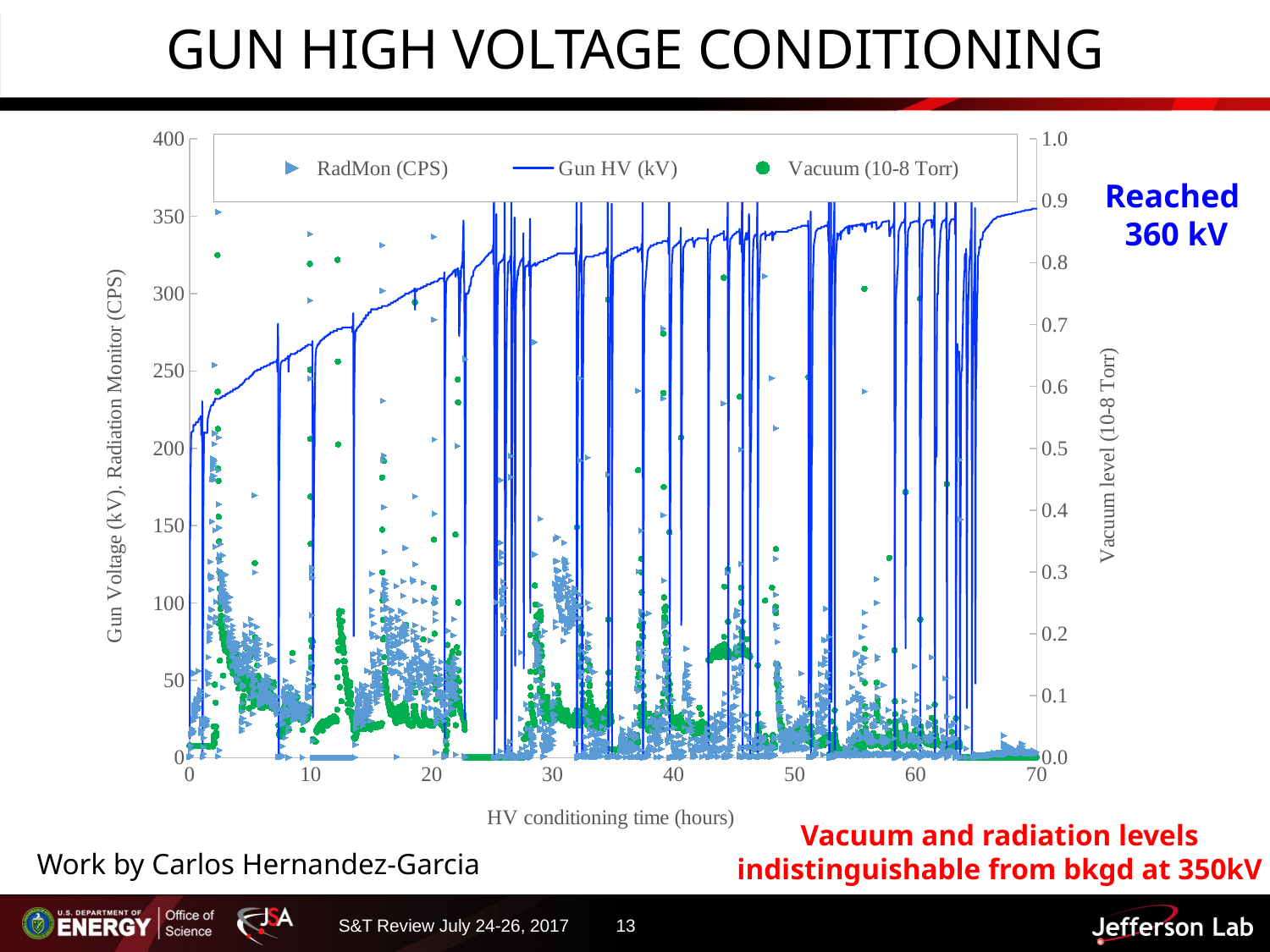
What are the three series named in the chart legend? RadMon (CPS), Gun HV (kV), Vacuum (10-8 Torr) What is the maximum value shown on the right-hand vacuum level axis? 1.0 Is the Gun HV (kV) value at 60 hours greater or less than 300? greater Which series is plotted as a continuous line rather than as scattered markers? Gun HV (kV) What is the label of the x axis of the chart? HV conditioning time (hours) Does the Gun HV (kV) line generally rise or fall as HV conditioning time increases? rise Is the Gun HV (kV) value at 40 hours greater or less than 300? greater What is the maximum HV conditioning time shown on the x axis? 70 How many series does the chart legend list? 3 Is the Gun HV (kV) value at 10 hours greater or less than 300? less What is the maximum value shown on the left-hand axis of the chart? 400